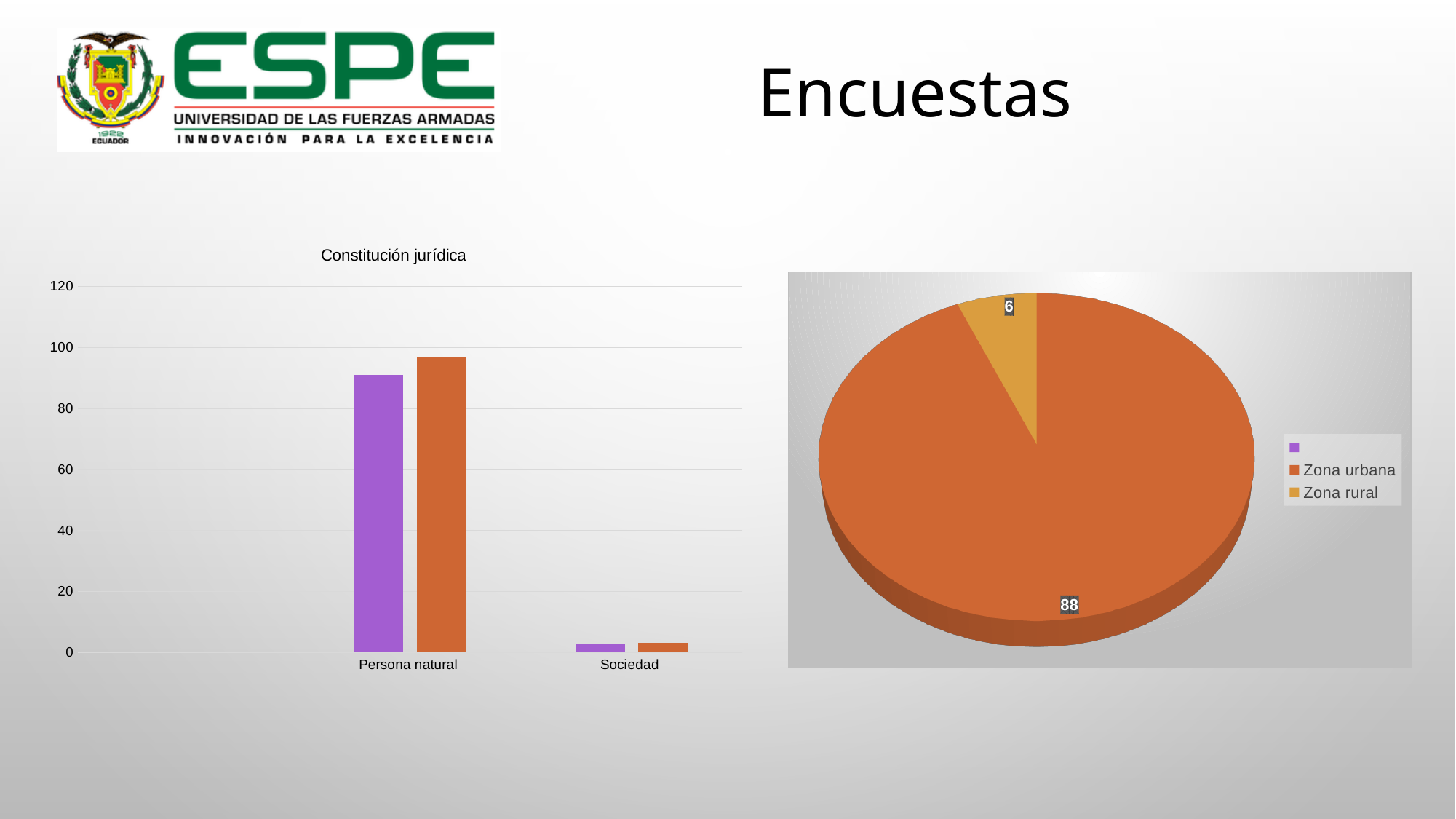
What is the title of the bar chart on the left side of the slide? Constitución jurídica In the bar chart titled 'Constitución jurídica', how many categories are shown on the x axis? 2 In the pie chart on the right, what is the value for Zona urbana? 88 What kind of chart is the chart titled 'Constitución jurídica'? bar chart In the bar chart titled 'Constitución jurídica', is the value of the orange bar for Sociedad greater or less than 20? less In the pie chart on the right, what is the value for Zona rural? 6 In the pie chart on the right, what is the difference between the values for Zona urbana and Zona rural? 82 In the bar chart titled 'Constitución jurídica', is the value of the orange bar for Persona natural greater or less than 100? less In the bar chart titled 'Constitución jurídica', is the value of the purple bar for Persona natural greater or less than 80? greater In the bar chart titled 'Constitución jurídica', which category has the higher bars, Persona natural or Sociedad? Persona natural What kind of chart is the chart on the right side of the slide? pie chart In the pie chart on the right, which slice is the largest? Zona urbana